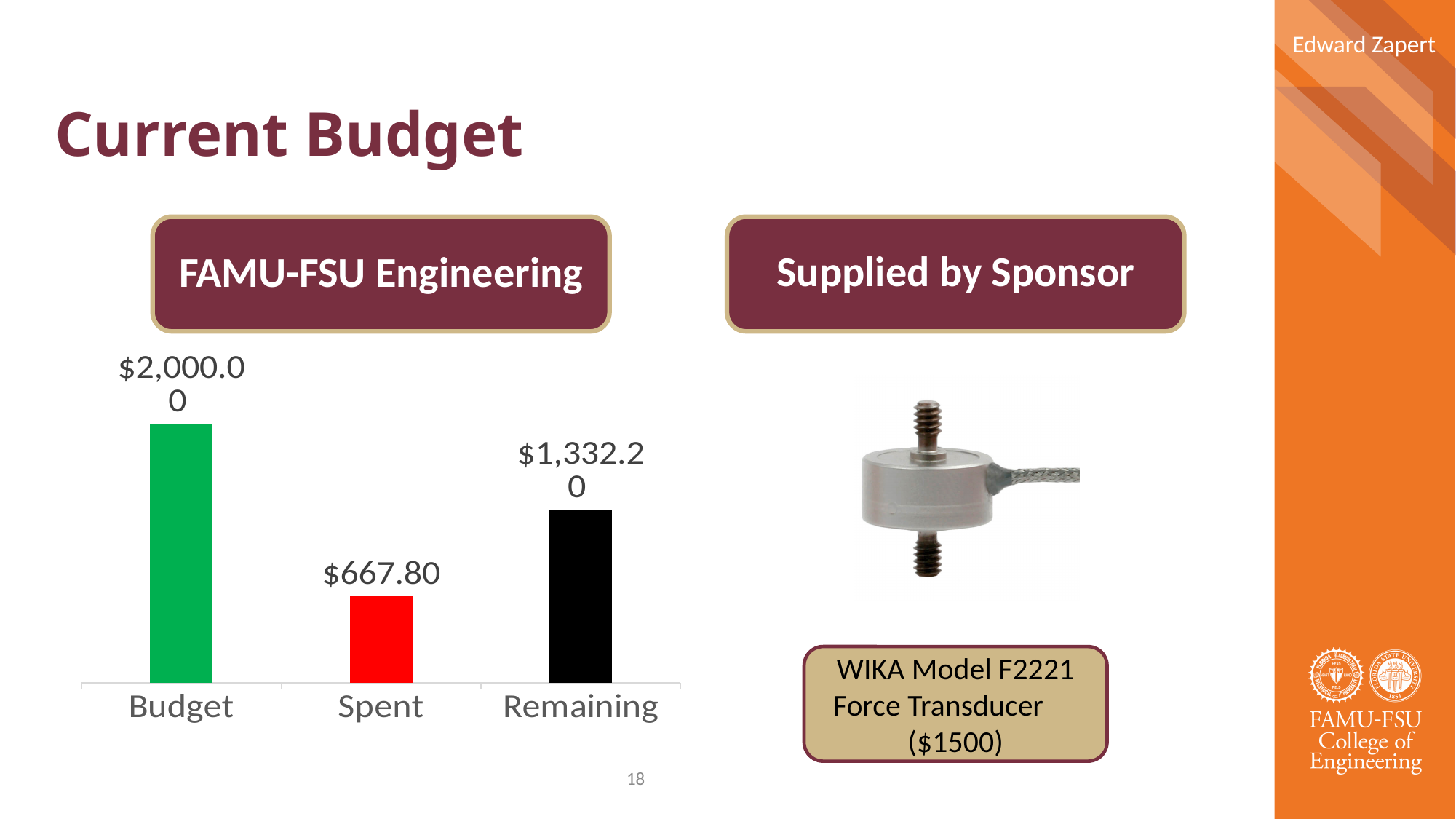
What is the difference between the Budget and Spent values? $1,332.20 What is the value of the Budget bar? $2,000.00 Which is larger, Spent or Remaining? Remaining What is the difference between the Remaining and Spent values? $664.40 What colour is the Spent bar? Red Which category has the lowest value? Spent What is the value of the Remaining bar? $1,332.20 What colour is the Budget bar? Green What kind of chart is shown on the slide? Bar chart What is the value of the Spent bar? $667.80 How many categories are shown in the chart? 3 Which category has the highest value? Budget